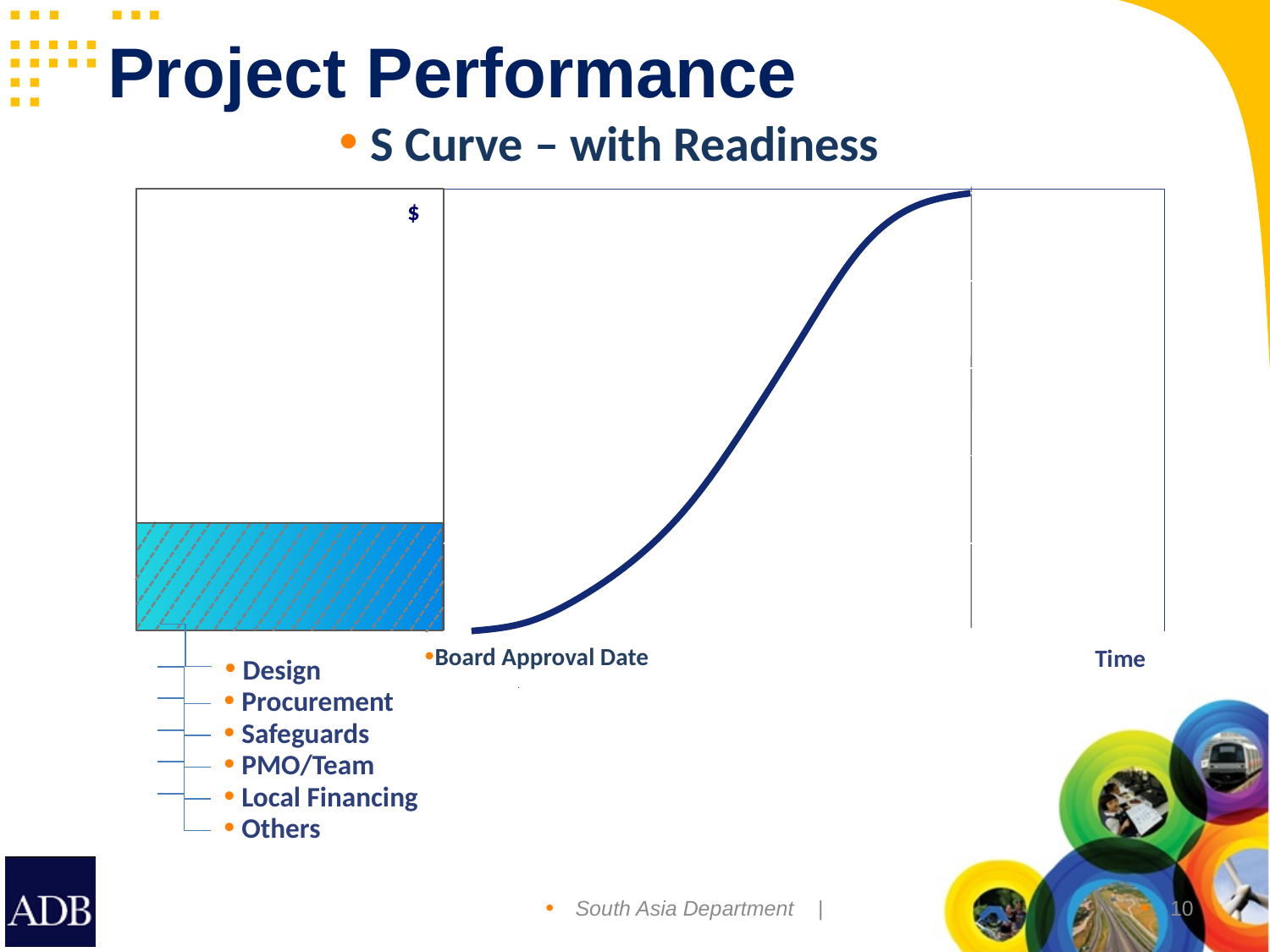
What are the labels on the vertical and horizontal axes of the chart? $ and Time What kind of chart is shown on the slide? line chart What event does the vertical line at the start of the curve mark? Board Approval Date Does the curve rise or fall as it moves along the Time axis? rises How many readiness items are listed below the shaded block on the chart? 6